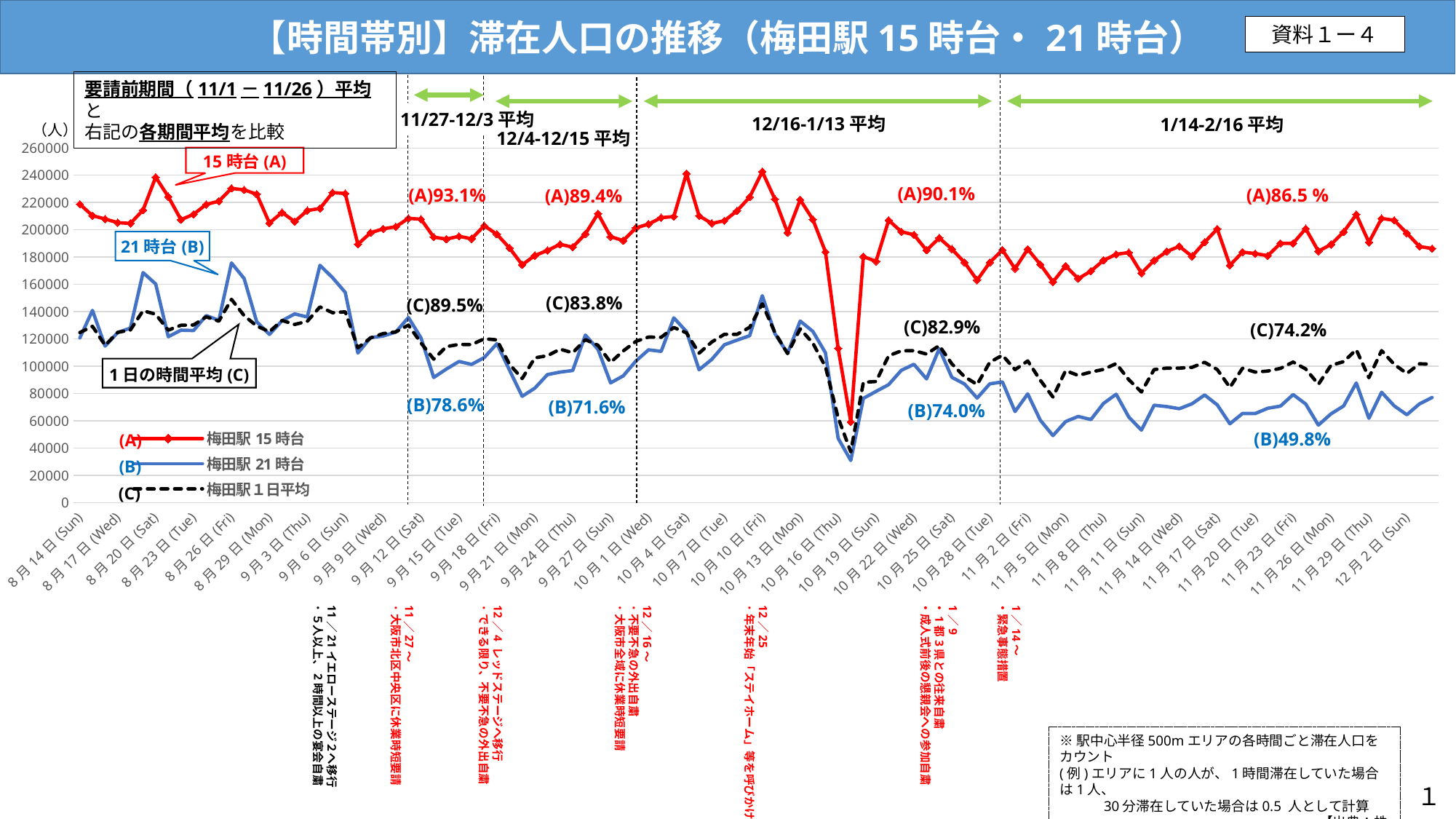
Which series stays highest across the whole chart? 梅田駅 15 時台 Which is larger in the 12/4-12/15 平均 period, the (C) percentage or the (B) percentage? (C) 83.8% How many series does the legend list? 3 Is the value of the 梅田駅 21 時台 line at 8月14日 (Sun) greater or less than 100000? greater What is the (B) percentage shown for the 1/14-2/16 平均 period? 49.8% Among the four periods, in which period is the (B) percentage lowest? 1/14-2/16 平均 What unit is shown on the vertical axis? 人 What is the (C) percentage shown for the 12/16-1/13 平均 period? 82.9% Among the four periods, in which period is the (A) percentage highest? 11/27-12/3 平均 What is the difference between the (A) and (B) percentages in the 11/27-12/3 平均 period? 14.5 percentage points What is the (A) percentage shown for the 11/27-12/3 平均 period? 93.1% What kind of chart is shown on the slide? line chart